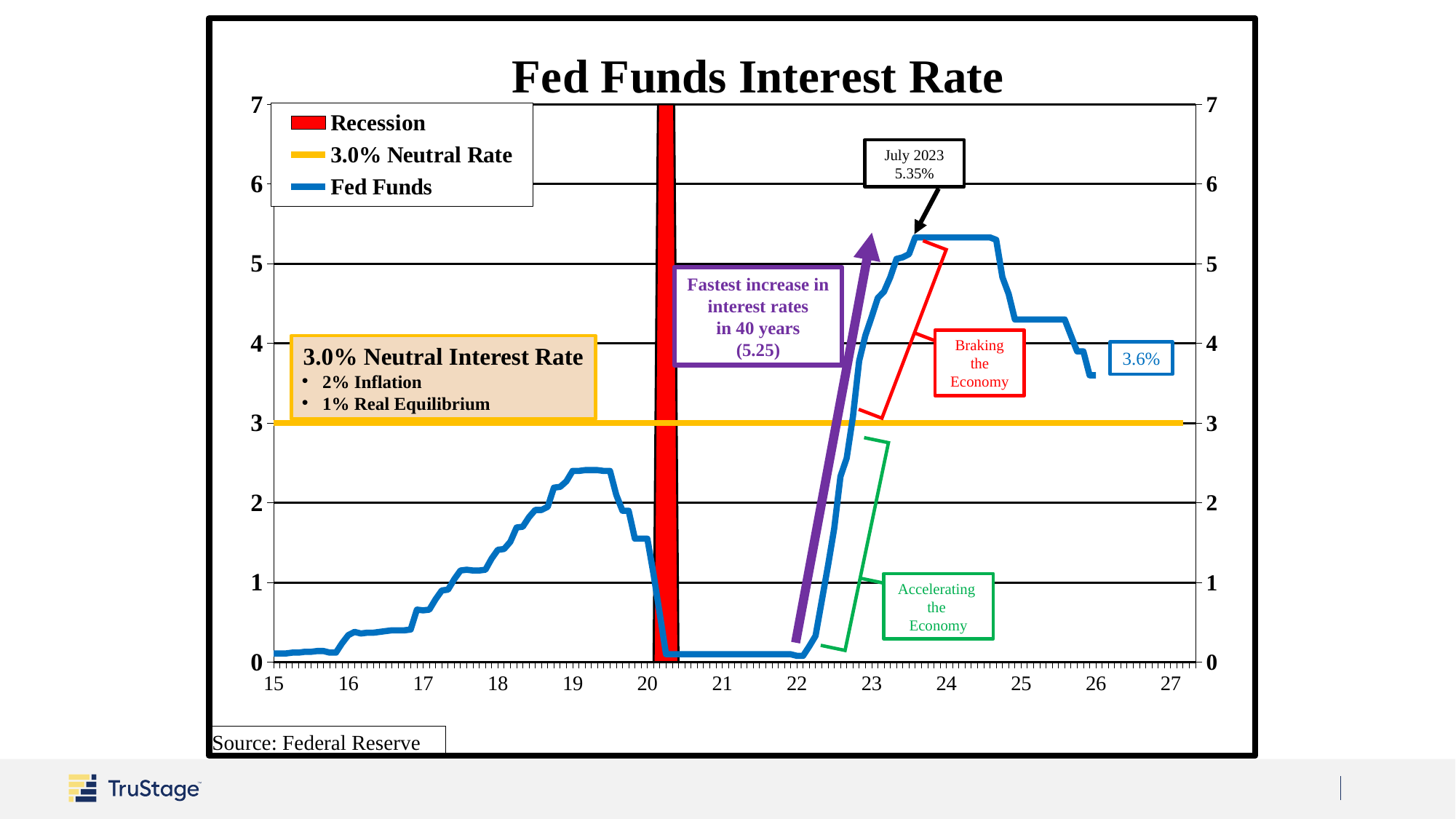
Does the Fed Funds line rise or fall between 24 and 26? fall What Fed Funds rate is labelled for July 2023? 5.35% Which is larger, the July 2023 Fed Funds rate or the neutral rate? July 2023 Fed Funds rate What value is labelled at the end of the Fed Funds line near 26? 3.6% Does the Fed Funds line rise or fall between 22 and 23? rise What kind of chart is shown on the slide? line chart What colour is the Fed Funds line? blue What is the value of the neutral rate line shown on the chart? 3.0% Is the Fed Funds rate at 21 greater or less than 1? less How many entries does the chart's legend list? 3 What is the title of the chart? Fed Funds Interest Rate Is the Fed Funds rate at 19 greater or less than 2? greater